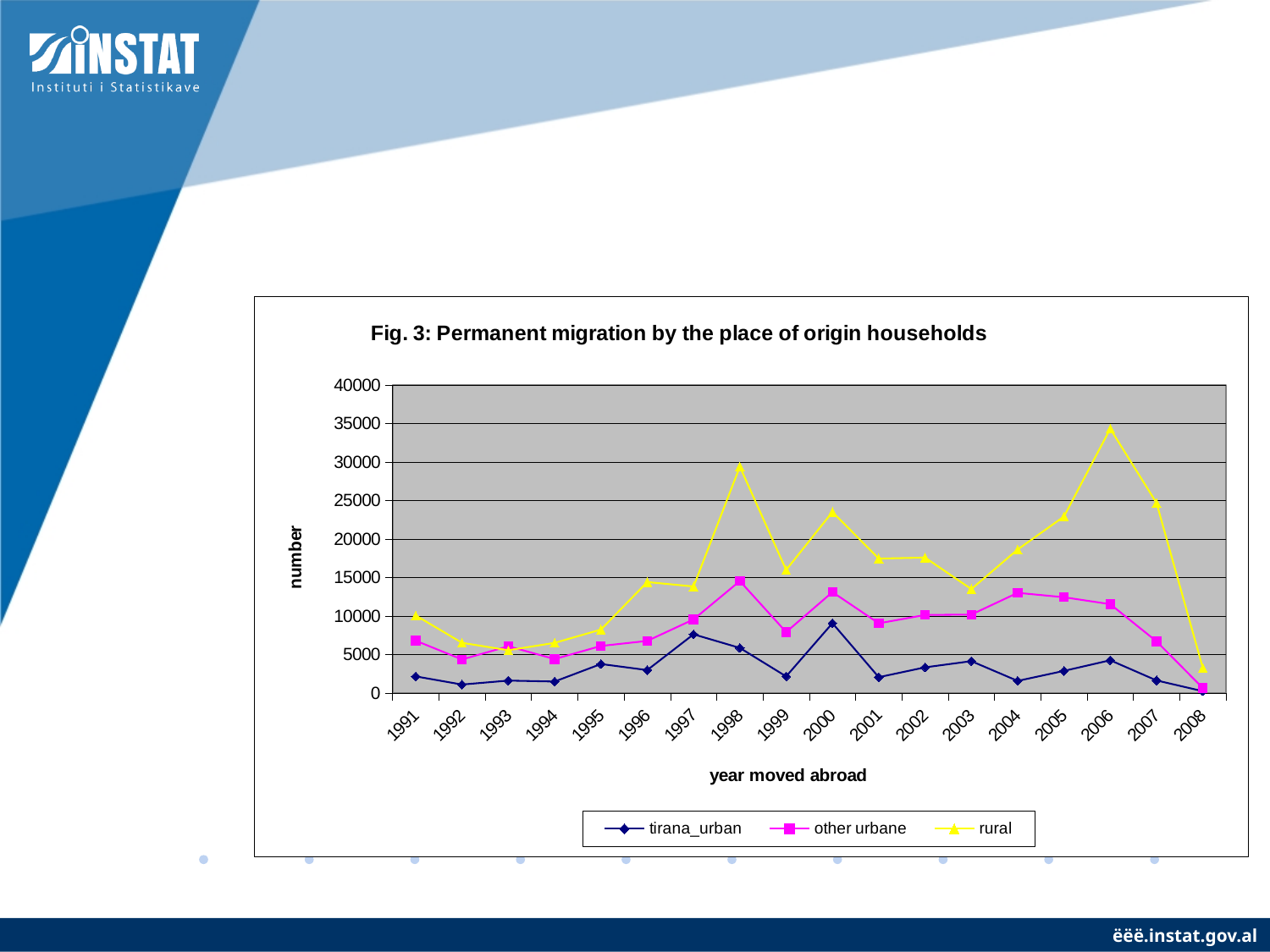
In which year does the other urbane series reach its highest value? 1998 What is the title of the x axis? year moved abroad In which year is the rural series at its lowest? 2008 Is the tirana_urban value for 2000 greater or less than 10000? less In which year does the rural series reach its highest value? 2006 How many years are plotted along the x axis? 18 Is the rural value for 2006 greater or less than 30000? greater How many series does the legend list? 3 Is the rural value for 1998 greater or less than 25000? greater In which year does the tirana_urban series reach its highest value? 2000 What kind of chart is shown in Fig. 3? line chart In 2000, which series has the larger value, rural or other urbane? rural